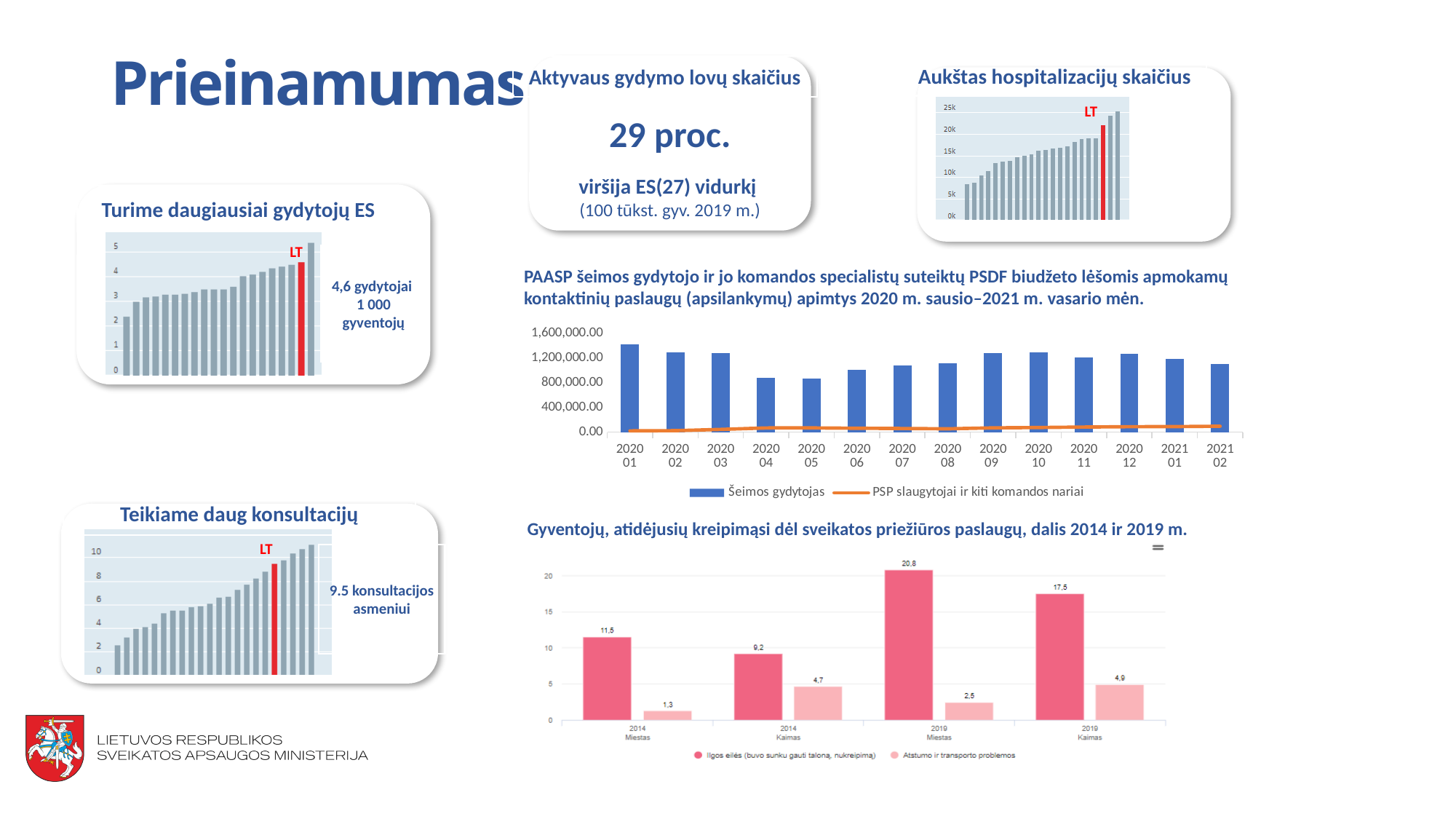
In the chart titled "Gyventojų, atidėjusių kreipimąsi dėl sveikatos priežiūros paslaugų, dalis 2014 ir 2019 m.", what is the difference between the "Ilgos eilės" values for 2019 Miestas and 2014 Miestas? 9,3 In the chart titled "Aukštas hospitalizacijų skaičius", is the value for the LT bar greater or less than 15k? greater In the PAASP chart ("PAASP šeimos gydytojo ir jo komandos specialistų..."), how many months are shown on the x axis? 14 In the chart titled "Gyventojų, atidėjusių kreipimąsi dėl sveikatos priežiūros paslaugų, dalis 2014 ir 2019 m.", which is larger: the "Ilgos eilės" value for 2014 Kaimas or for 2019 Kaimas? 2019 Kaimas In the chart titled "Turime daugiausiai gydytojų ES", what value is given for LT (doctors per 1 000 inhabitants)? 4,6 How many series does the legend list in the chart titled "Gyventojų, atidėjusių kreipimąsi dėl sveikatos priežiūros paslaugų, dalis 2014 ir 2019 m."? 2 In the chart titled "Gyventojų, atidėjusių kreipimąsi dėl sveikatos priežiūros paslaugų, dalis 2014 ir 2019 m.", which category has the highest "Ilgos eilės" value? 2019 Miestas In the PAASP chart ("PAASP šeimos gydytojo ir jo komandos specialistų..."), which series is drawn as a line? PSP slaugytojai ir kiti komandos nariai In the chart titled "Gyventojų, atidėjusių kreipimąsi dėl sveikatos priežiūros paslaugų, dalis 2014 ir 2019 m.", what is the value for "Atstumo ir transporto problemos" in 2014 Kaimas? 4,7 In the chart titled "Gyventojų, atidėjusių kreipimąsi dėl sveikatos priežiūros paslaugų, dalis 2014 ir 2019 m.", which category has the lowest "Atstumo ir transporto problemos" value? 2014 Miestas In the PAASP chart ("PAASP šeimos gydytojo ir jo komandos specialistų..."), is the "Šeimos gydytojas" value for 2020 05 greater or less than 1,200,000.00? less In the chart titled "Gyventojų, atidėjusių kreipimąsi dėl sveikatos priežiūros paslaugų, dalis 2014 ir 2019 m.", what is the value for "Ilgos eilės" in 2019 Miestas? 20,8